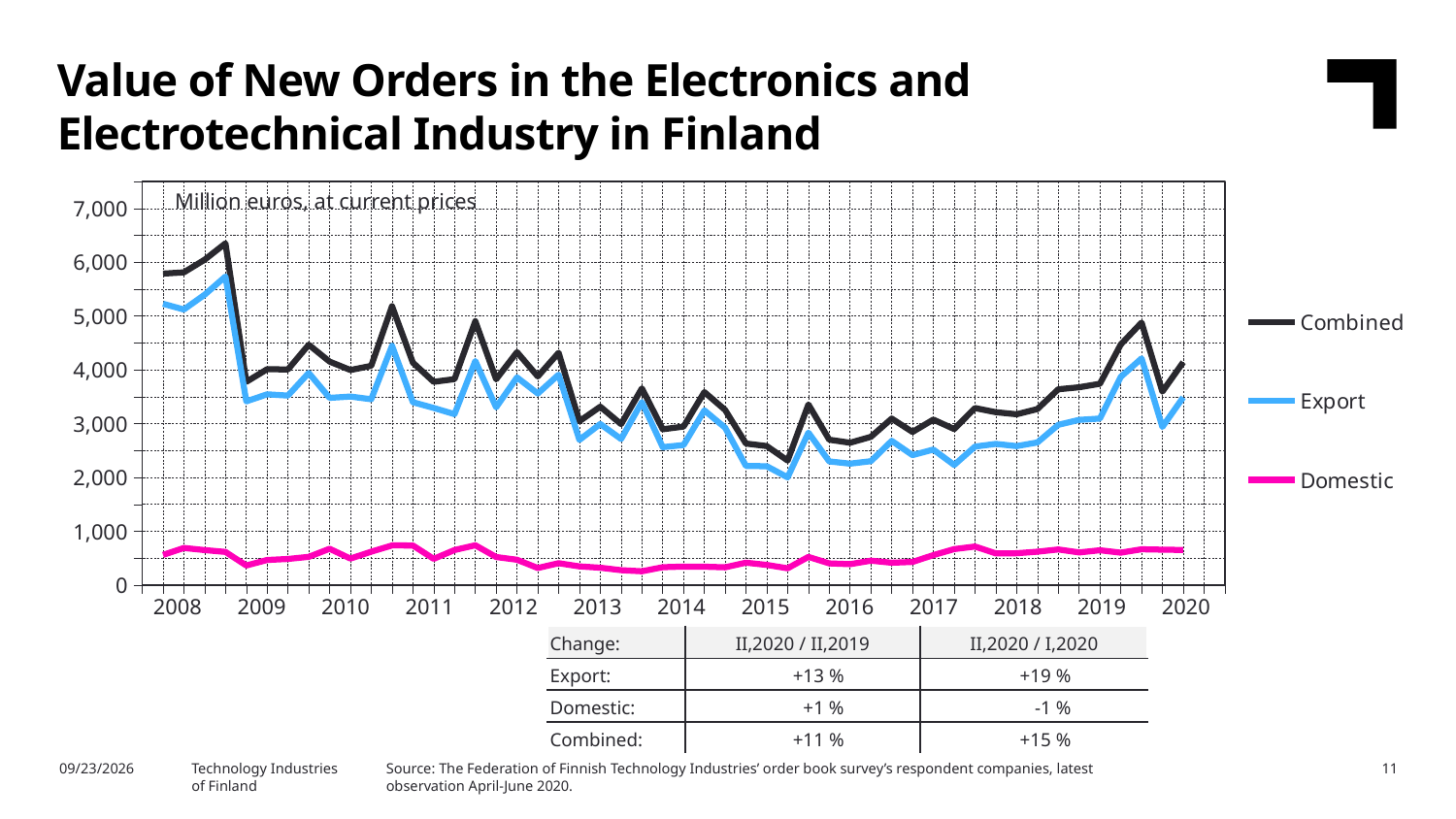
Which is larger in 2010, the Export value or the Domestic value? Export How many series does the legend list? 3 Which series has the lowest values throughout the chart? Domestic Does the Combined series overall rise or fall from 2008 to 2016? Fall Which series has the highest values throughout the chart? Combined What kind of chart is shown on the slide? Line chart Is the value of the Domestic series in 2012 greater or less than 1,000? less How many year labels are shown on the x axis? 13 Is the highest value of the Combined series in 2019 greater or less than 4,000? greater What unit label is shown at the top of the chart area? Million euros, at current prices Is the value of the Export series at the start of 2016 greater or less than 3,000? less